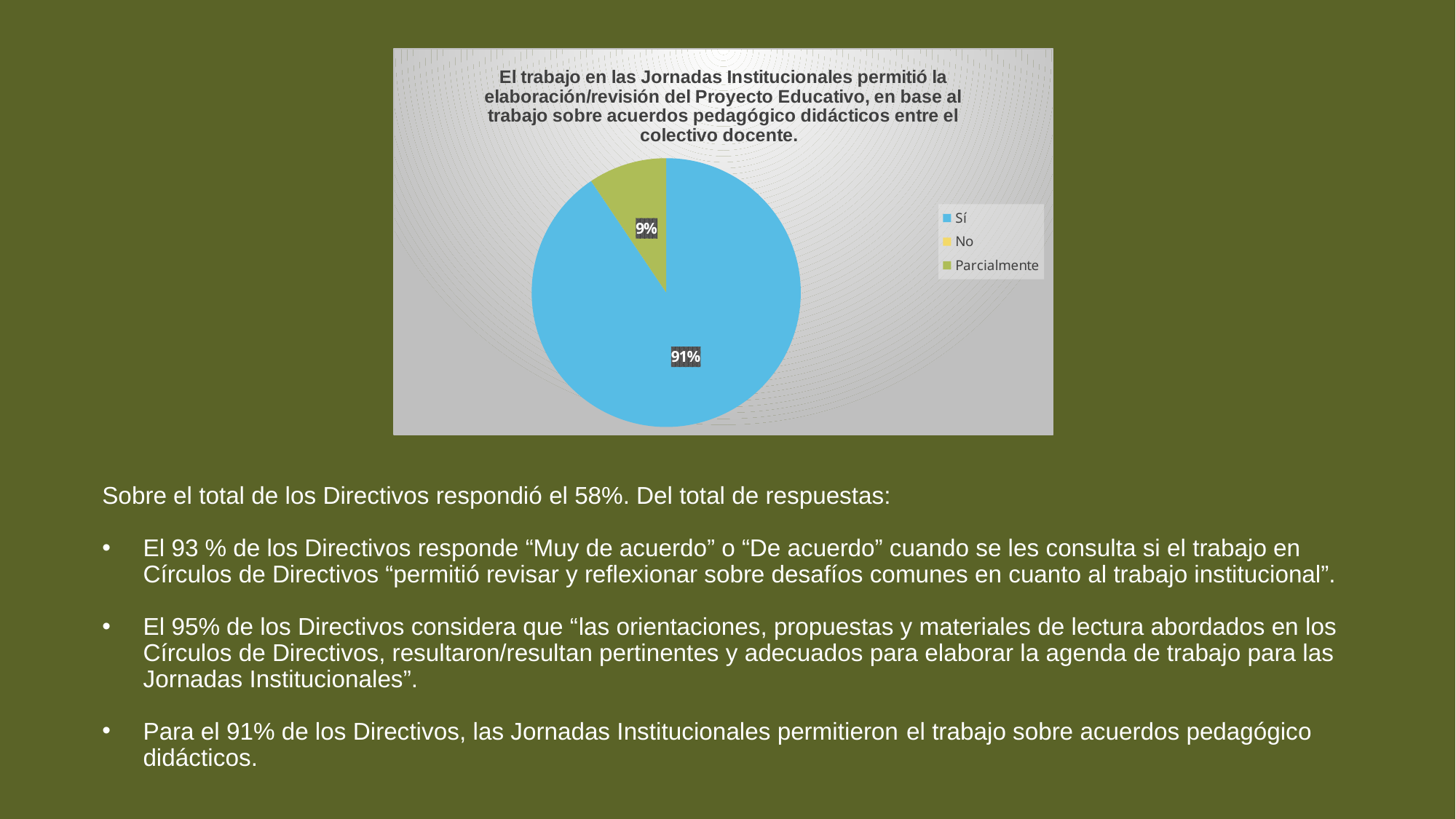
Is the share for "Sí" greater or less than 50%? greater Which of the two labelled slices is larger, "Sí" or "Parcialmente"? Sí What share of the pie does the "Sí" slice represent? 91% Which category has the largest slice of the pie? Sí What is the difference in percentage points between the "Sí" slice and the "Parcialmente" slice? 82 Which legend entry does not have a visible slice in the pie? No How many entries does the legend list? 3 What kind of chart is shown on the slide? pie chart What colour is the "Sí" slice of the pie? blue What share of the pie does the "Parcialmente" slice represent? 9%